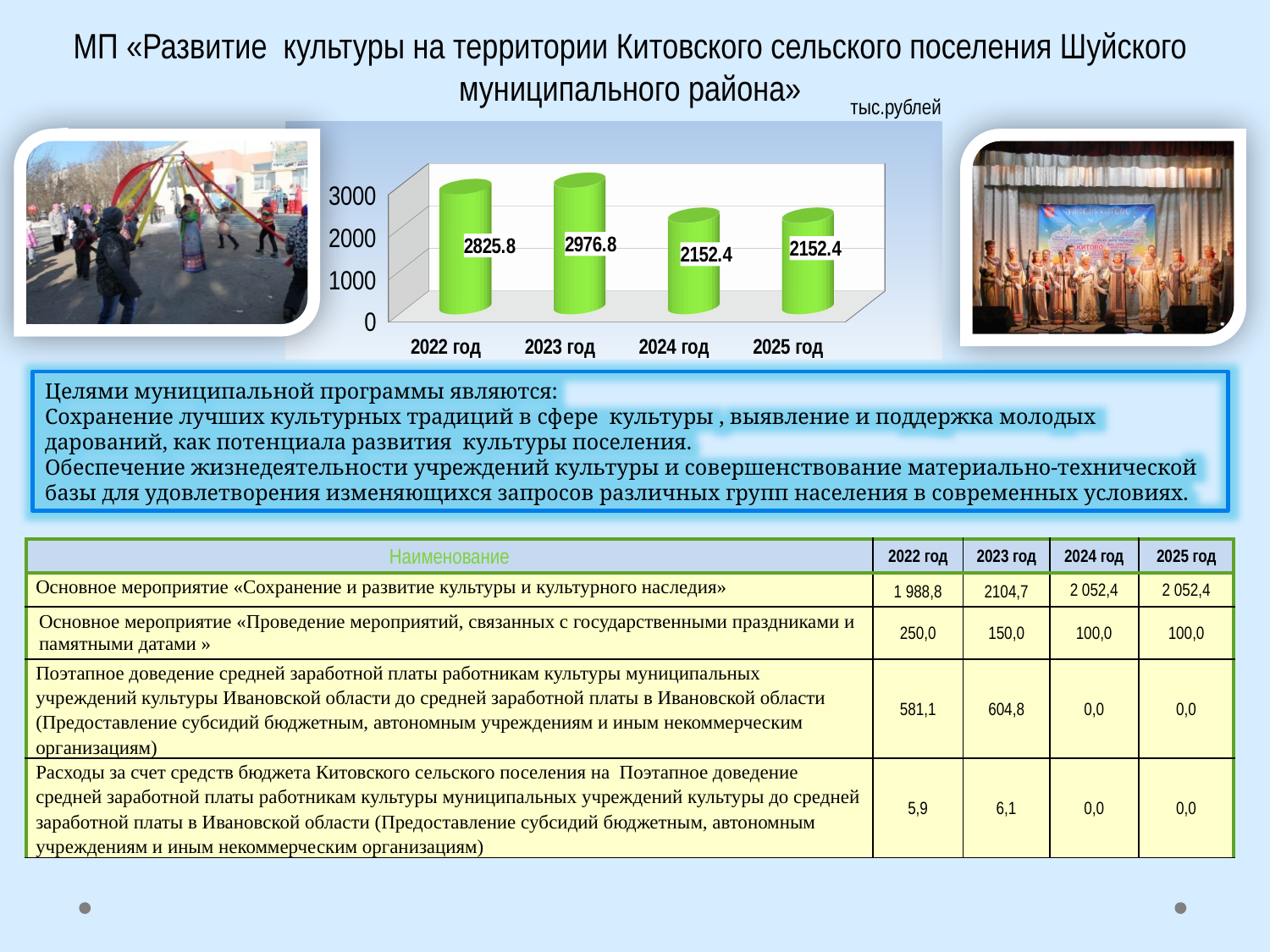
Which is larger, the value for 2022 год or the value for 2025 год? 2022 год What is the value for 2022 год? 2825.8 How many years are shown on the chart? 4 What unit is indicated above the chart? тыс.рублей Is the value for 2024 год greater or less than 3000? less What is the value for 2024 год? 2152.4 Which year has the highest value? 2023 год What kind of chart is shown on the slide? bar chart What is the difference between the values for 2022 год and 2024 год? 673.4 What is the value for 2023 год? 2976.8 What is the difference between the values for 2023 год and 2022 год? 151 Do the values rise or fall from 2023 год to 2024 год? fall